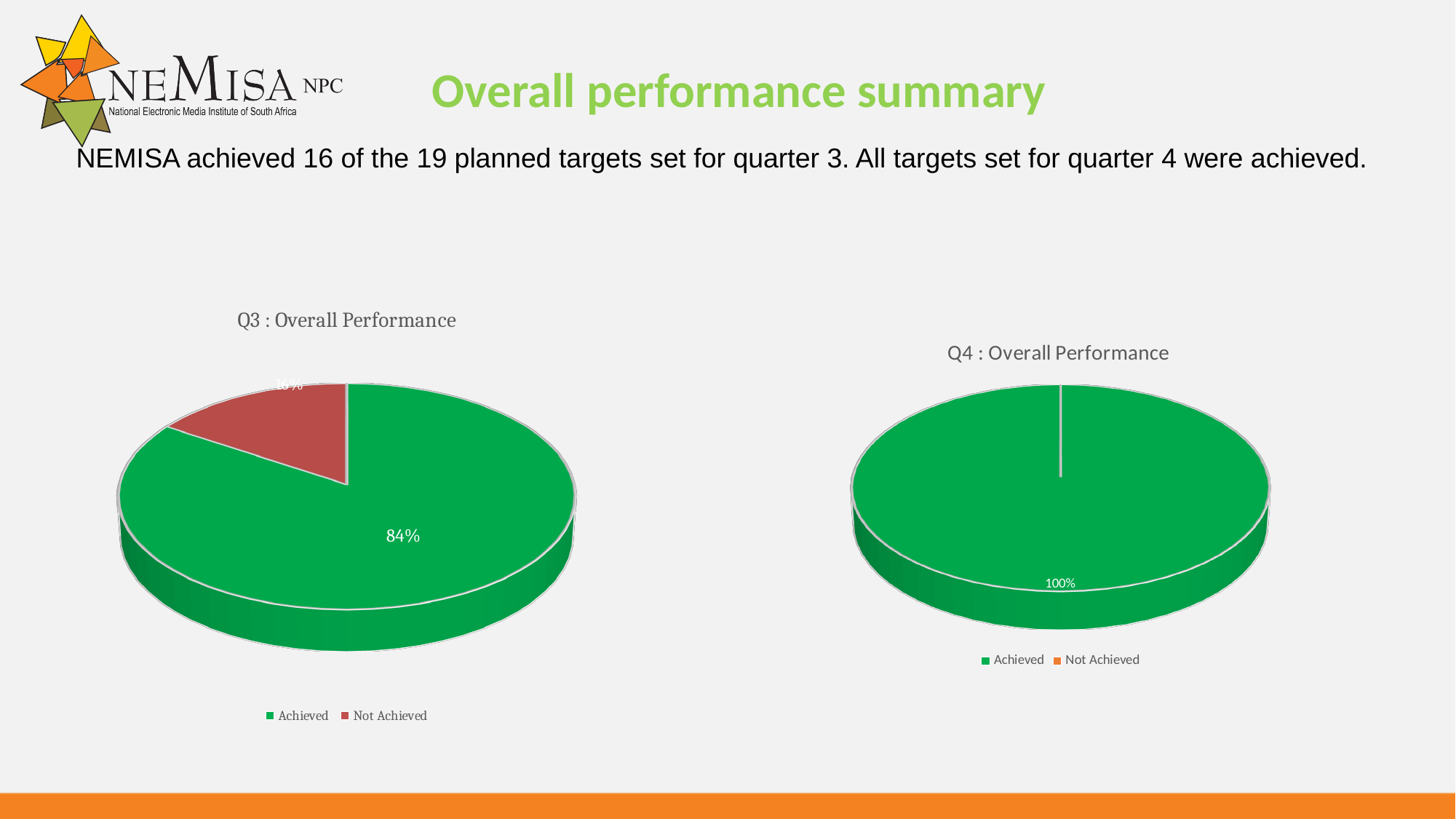
In the Q3 : Overall Performance chart, what share of the pie is Not Achieved? 16% In the Q3 : Overall Performance chart, which slice is the smallest? Not Achieved How many entries does the legend of the Q4 : Overall Performance chart list? 2 What is the title of the pie chart on the left of the slide? Q3 : Overall Performance What kind of chart is the Q3 : Overall Performance chart? Pie chart What colour is the Achieved slice in the Q4 : Overall Performance chart? Green In the Q3 : Overall Performance chart, which is larger, Achieved or Not Achieved? Achieved What kind of chart is the Q4 : Overall Performance chart? Pie chart In the Q3 : Overall Performance chart, what percentage of targets were Achieved? 84% In the Q4 : Overall Performance chart, what percentage of targets were Achieved? 100% In the Q3 : Overall Performance chart, which slice is the largest? Achieved How many entries does the legend of the Q3 : Overall Performance chart list? 2